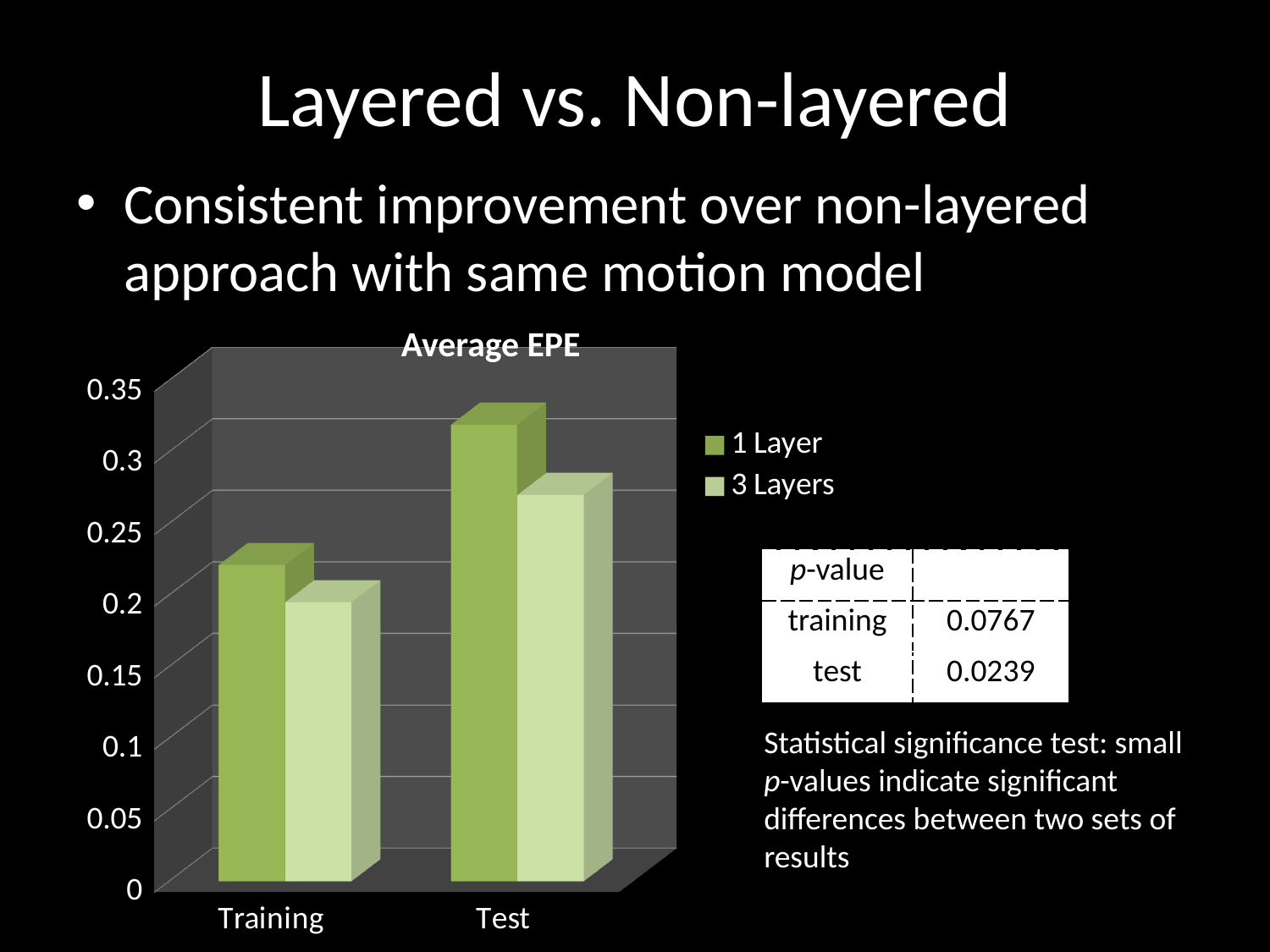
Which bar in the chart is the lowest? 3 Layers for Training How many categories are shown on the x axis of the chart? 2 What is the title of the chart? Average EPE For the Test category, which is larger: the 1 Layer value or the 3 Layers value? 1 Layer How many series does the chart legend list? 2 Which series is shown in the darker green colour in the chart? 1 Layer What kind of chart is shown on the slide? bar chart Is the 1 Layer value for Test greater or less than 0.3? greater Which bar in the chart is the highest? 1 Layer for Test Is the 3 Layers value for Test greater or less than 0.25? greater For the Training category, which is larger: the 1 Layer value or the 3 Layers value? 1 Layer Do the 1 Layer values rise or fall from Training to Test? rise